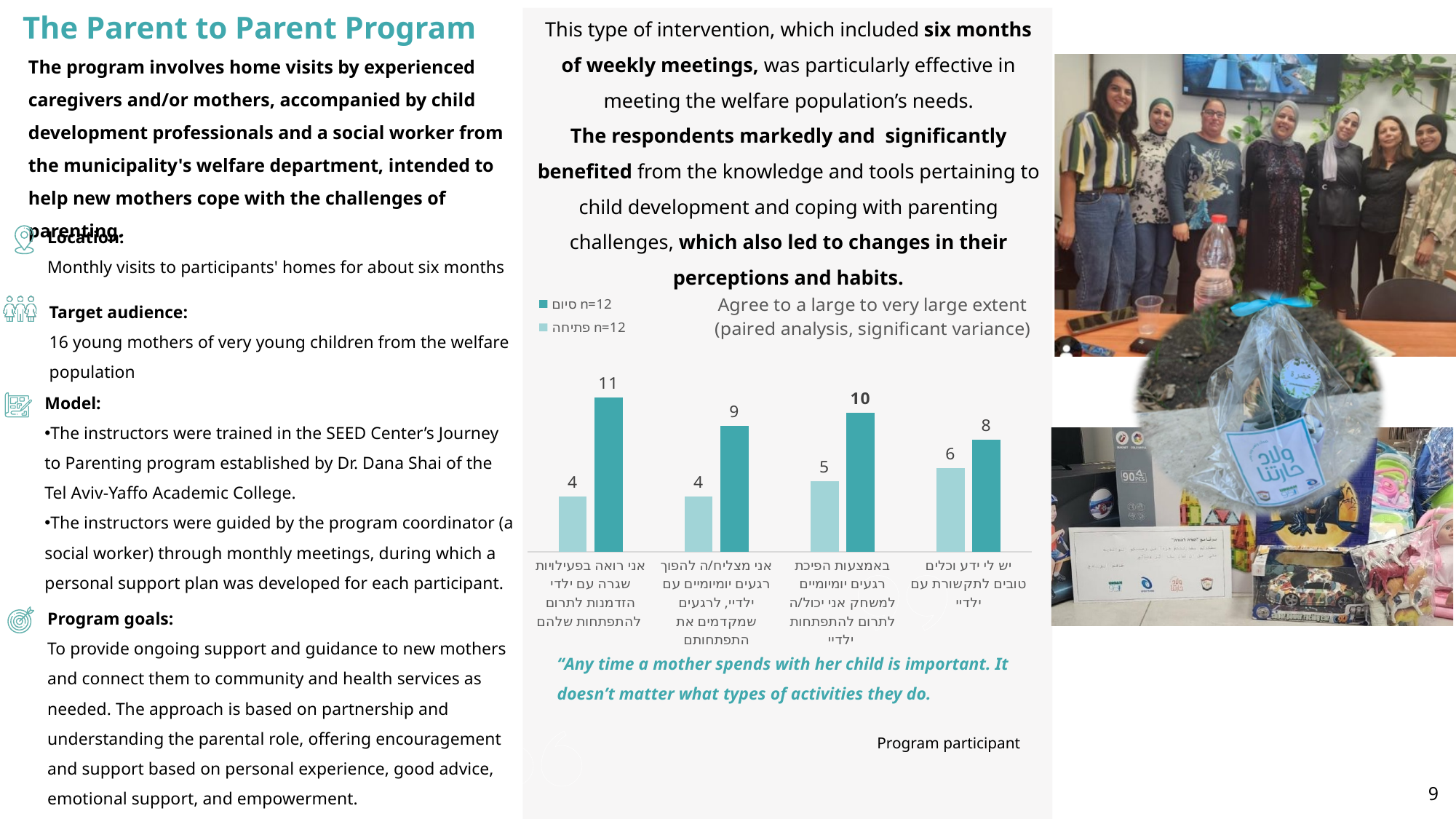
What is the value of the 'סיום n=12' bar for the third category from the left (באמצעות הפיכת רגעים יומיומיים למשחק)? 10 What is the value of the dark teal 'סיום n=12' bar for the leftmost category (אני רואה בפעילויות שגרה עם ילדי הזדמנות לתרום להתפתחות שלהם)? 11 Which category has the lowest 'סיום n=12' value? יש לי ידע וכלים טובים לתקשורת עם ילדיי What is the value of the light teal 'פתיחה n=12' bar for the rightmost category (יש לי ידע וכלים טובים לתקשורת עם ילדיי)? 6 Which category has the highest 'סיום n=12' value? אני רואה בפעילויות שגרה עם ילדי הזדמנות לתרום להתפתחות שלהם What is the title of the chart? Agree to a large to very large extent (paired analysis, significant variance) For the second category from the left (אני מצליח/ה להפוך רגעים יומיומיים), which is larger: the 'פתיחה n=12' value or the 'סיום n=12' value? סיום n=12 What type of chart is shown on the slide? bar chart What is the difference between the 'סיום n=12' and 'פתיחה n=12' values for the leftmost category? 7 What is the difference between the 'סיום n=12' and 'פתיחה n=12' values for the rightmost category? 2 How many categories are shown on the x axis of the chart? 4 How many series does the chart legend list? 2